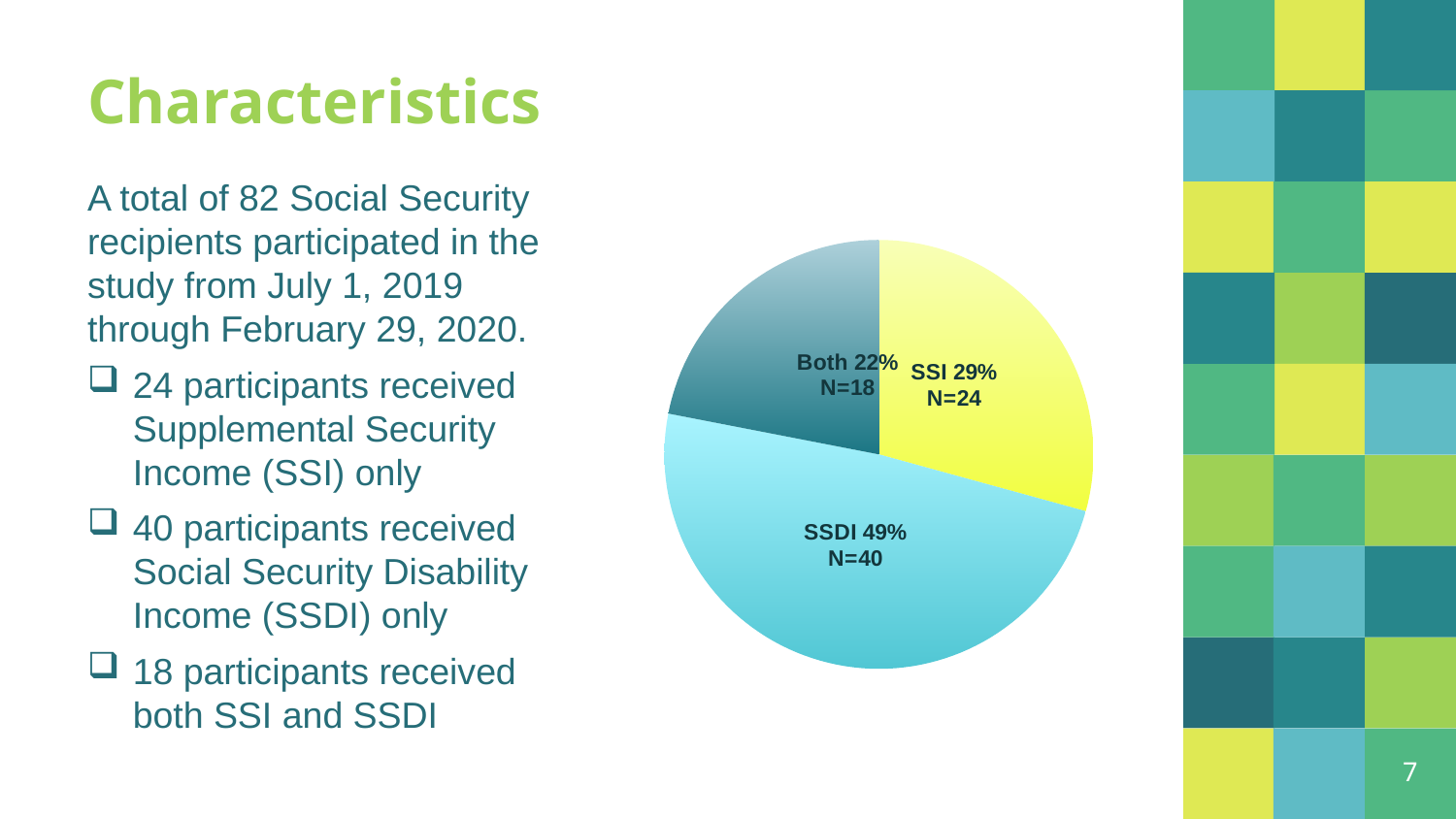
What kind of chart is shown on the slide? pie chart How many slices does the pie chart have? 3 What percentage of participants received SSDI only? 49% What is the total N across all three slices of the pie chart? 82 Which slice of the pie chart is the largest? SSDI What is the difference in N between the SSDI slice and the SSI slice? 16 Which is larger, the SSI slice or the Both slice? SSI What is the N value for the SSI slice? N=24 What percentage is shown for the Both slice? 22% What colour is the SSDI slice of the pie chart? light blue What share of the pie does the SSI slice represent? 29% Which slice of the pie chart is the smallest? Both